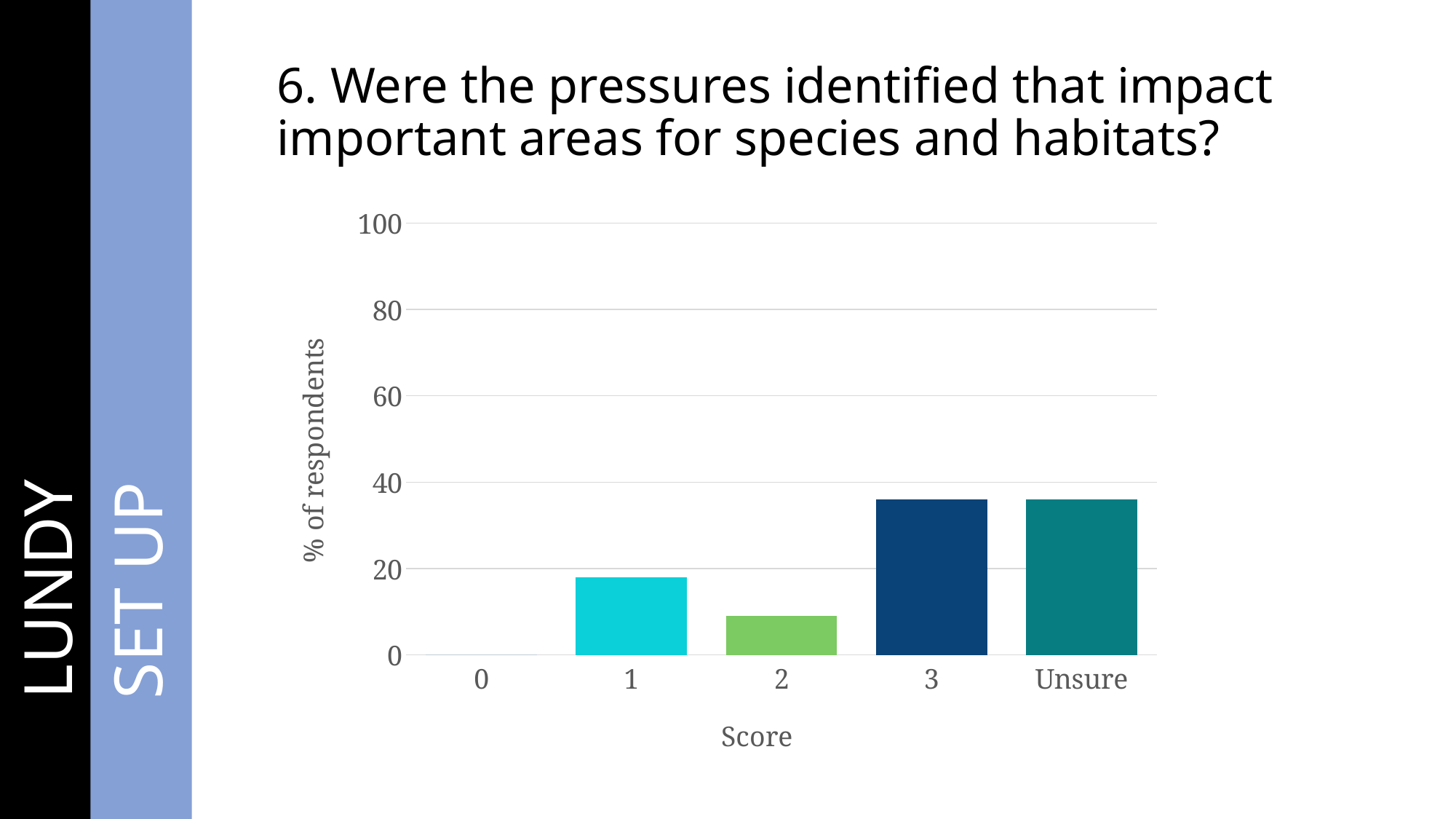
Which has the larger value, score 1 or score 2? 1 What is the label of the vertical axis? % of respondents Is the value for score 3 greater or less than 20? greater Which has the larger value, score 3 or score 1? 3 Is the value for score 3 greater or less than 40? less How many score categories are shown on the x axis? 5 Is the value for score 1 greater or less than 20? less What is the label of the horizontal axis? Score What kind of chart is shown on the slide? bar chart Which score category has the lowest value? 0